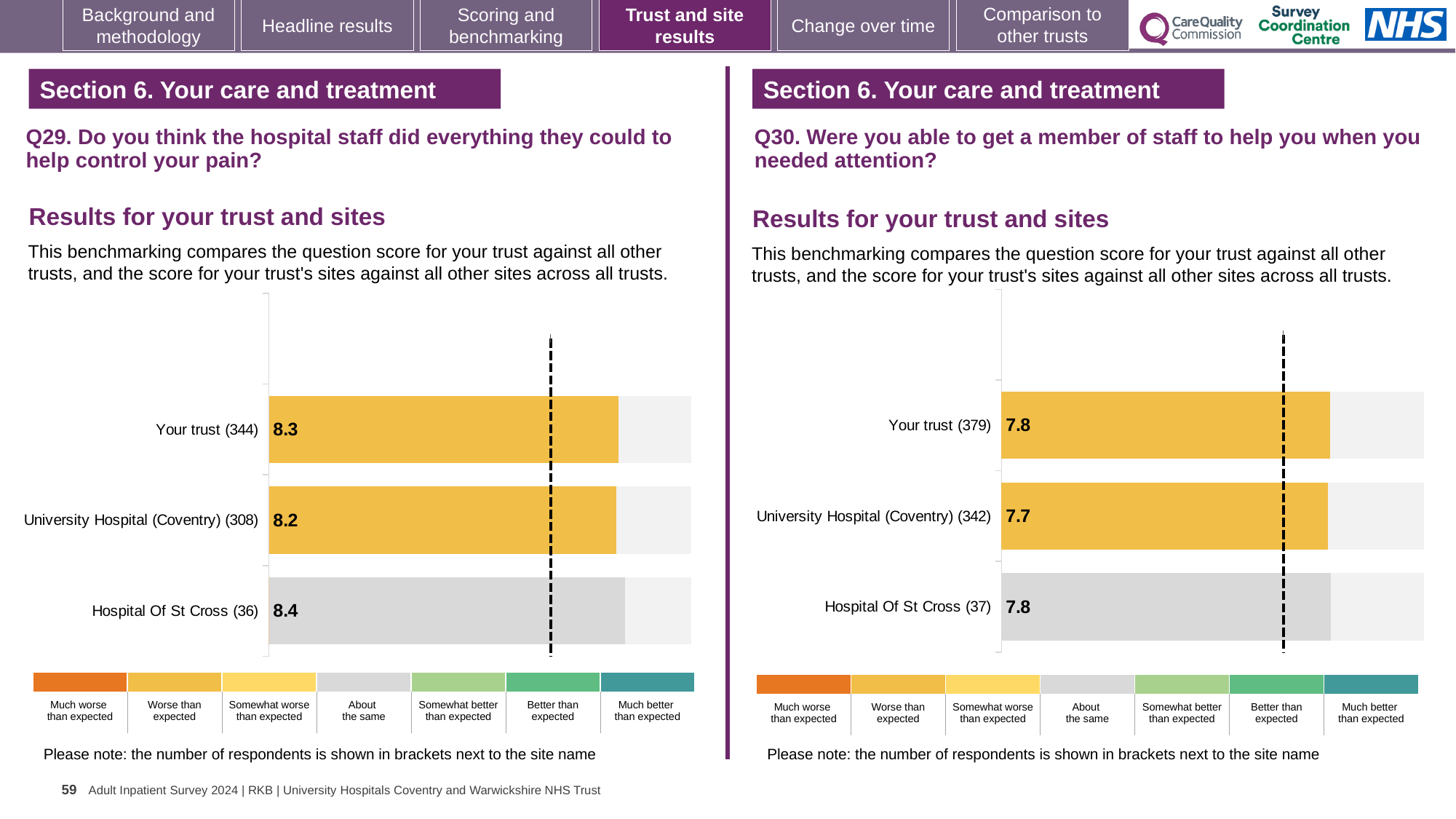
What kind of chart is used for the Q29 results on the left? Bar chart How many bars are plotted in the Q30 chart on the right? 3 In the Q30 chart on the right, what is the score for University Hospital (Coventry) (342)? 7.7 In the Q29 chart on the left, which site or trust has the lowest score? University Hospital (Coventry) (308) In the Q29 chart on the left, what is the score for Hospital Of St Cross (36)? 8.4 In the Q29 chart on the left, which has the larger score: Your trust (344) or University Hospital (Coventry) (308)? Your trust (344) In the Q29 chart on the left, what is the difference between the scores for Hospital Of St Cross (36) and University Hospital (Coventry) (308)? 0.2 In the Q30 chart on the right, which site or trust has the lowest score? University Hospital (Coventry) (342) In the Q29 chart on the left, which site or trust has the highest score? Hospital Of St Cross (36) In the Q30 chart on the right, what is the score for Your trust (379)? 7.8 In the Q29 chart on the left, what is the score for Your trust (344)? 8.3 In the Q30 chart on the right, what is the difference between the scores for Your trust (379) and University Hospital (Coventry) (342)? 0.1